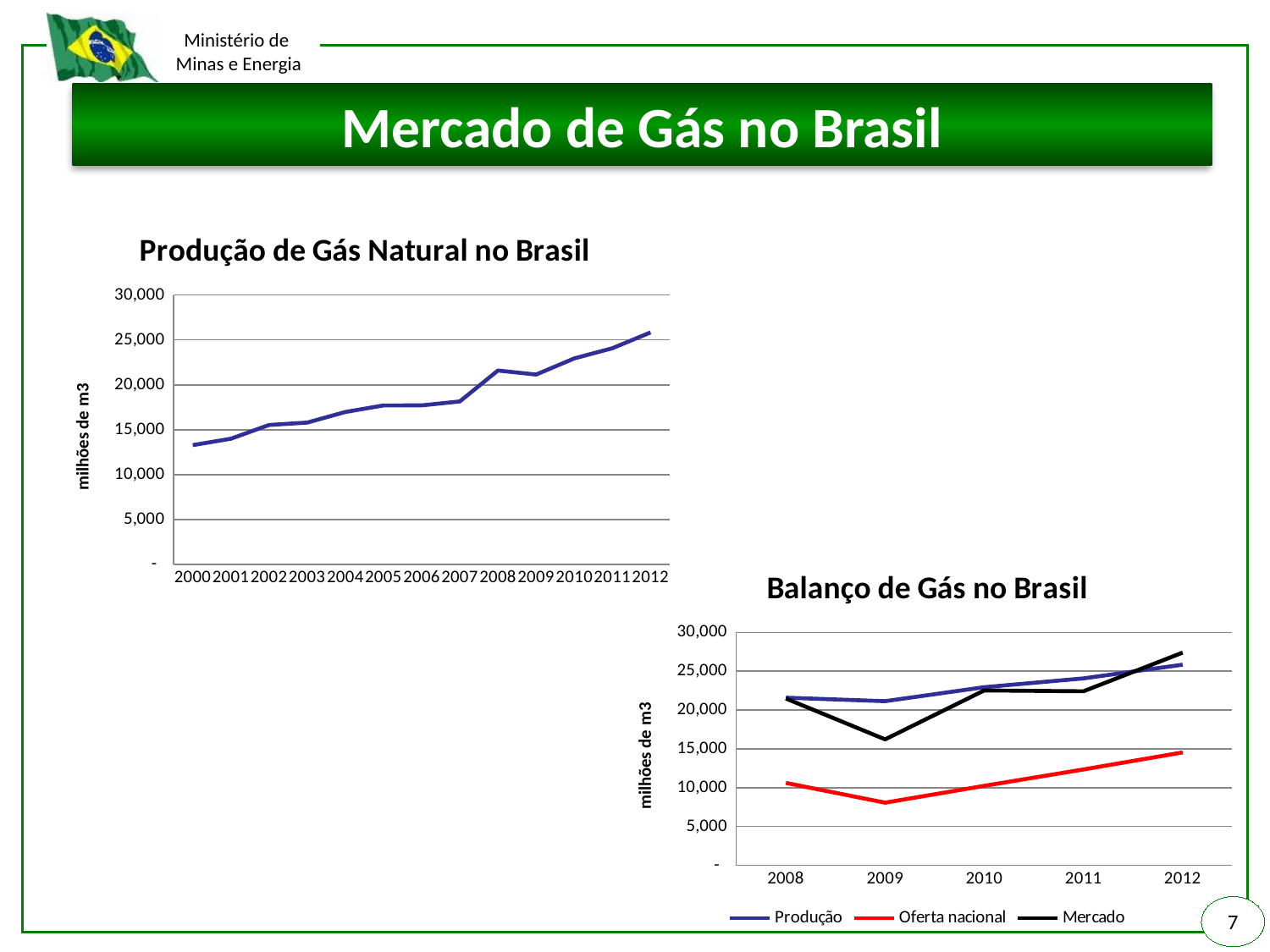
In the 'Produção de Gás Natural no Brasil' chart, which year has the lowest value? 2000 In the 'Balanço de Gás no Brasil' chart, which series has the lowest values across all years? Oferta nacional In the 'Balanço de Gás no Brasil' chart, is the value of Mercado in 2009 greater or less than 20,000? less What type of chart is the 'Produção de Gás Natural no Brasil' chart? line chart In the 'Produção de Gás Natural no Brasil' chart, do the values generally rise or fall from 2000 to 2012? rise In the 'Produção de Gás Natural no Brasil' chart, how many years are plotted on the x axis? 13 In the 'Produção de Gás Natural no Brasil' chart, is the value for 2000 greater or less than 15,000? less In the 'Produção de Gás Natural no Brasil' chart, which year has the highest value? 2012 In the 'Produção de Gás Natural no Brasil' chart, is the value for 2008 greater or less than 20,000? greater In the 'Balanço de Gás no Brasil' chart, which is larger in 2009: Produção or Mercado? Produção In the 'Balanço de Gás no Brasil' chart, what colour is the line for Oferta nacional? red How many series does the legend of the 'Balanço de Gás no Brasil' chart list? 3